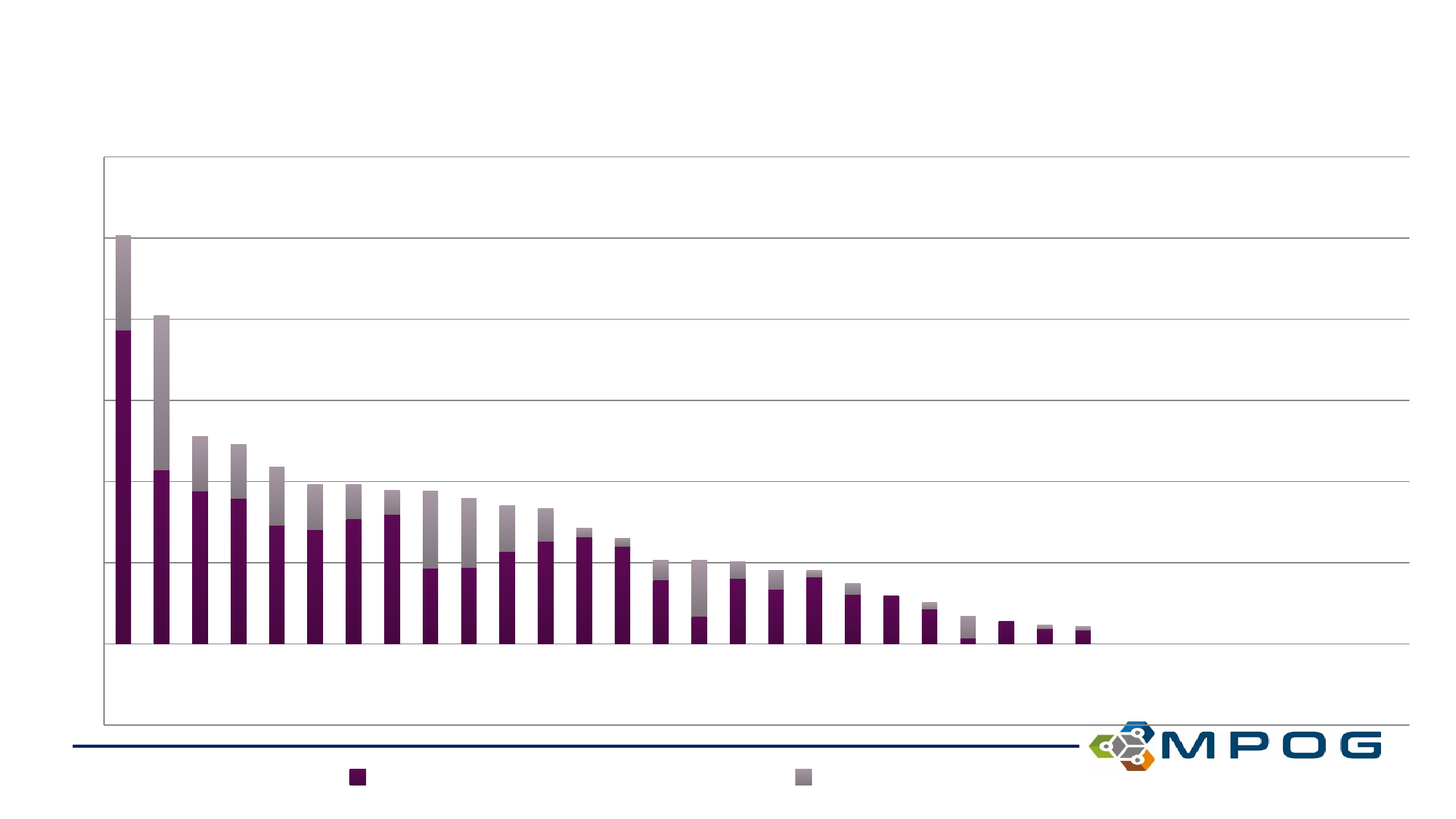
Which series is drawn at the bottom of each stacked bar, the purple one or the grey one? the purple one How many series does the legend list? 2 How many bars are plotted in the chart? 26 What kind of chart is shown on the slide? stacked bar chart Which bar is the tallest in the chart? the leftmost (first) bar Do the bar heights rise or fall from left to right along the x axis? fall What two colours are used for the series in the chart? purple and grey Which is taller, the first bar from the left or the second bar from the left? the first bar